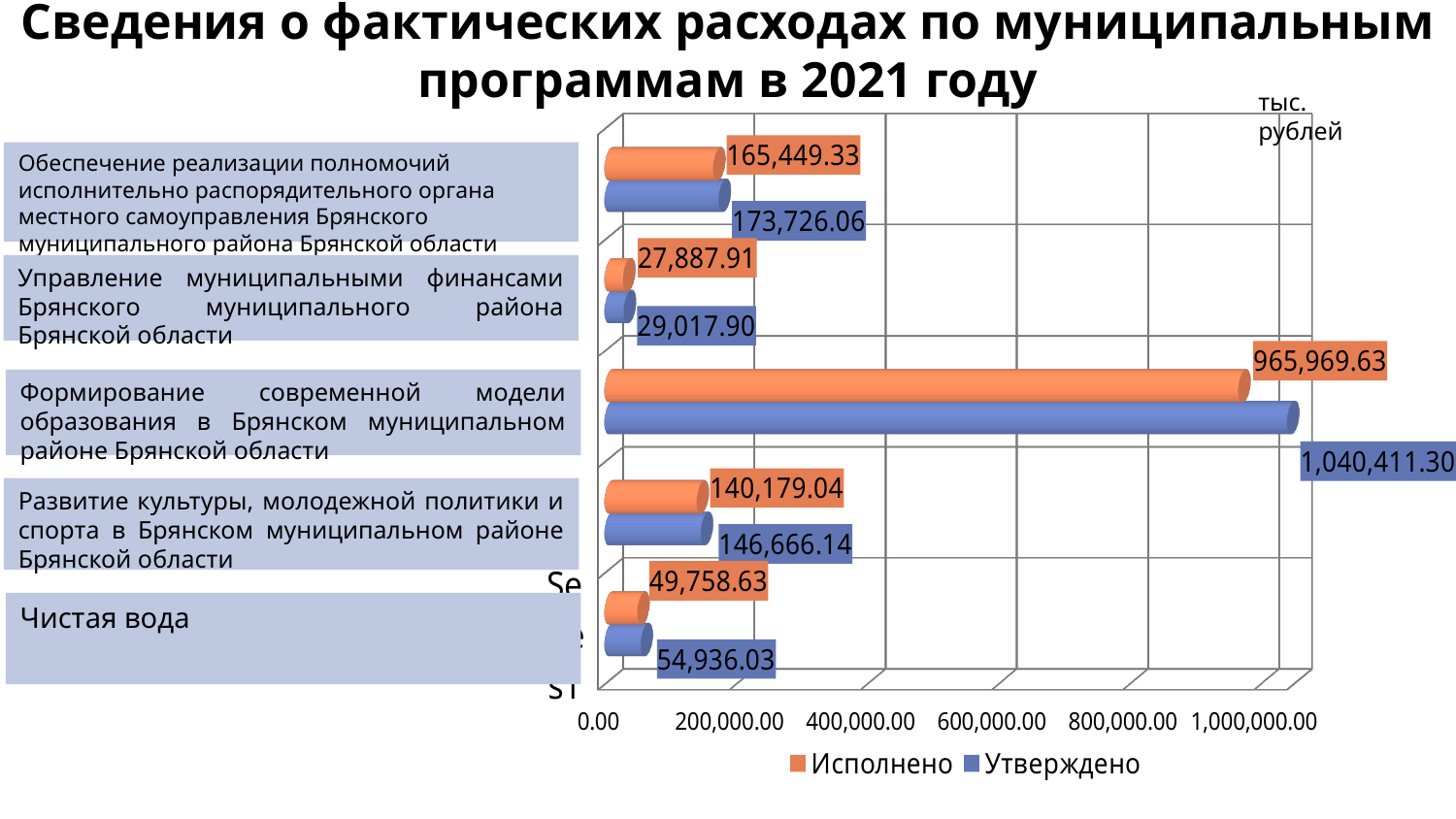
What is the Утверждено value for Формирование современной модели образования в Брянском муниципальном районе Брянской области? 1,040,411.30 What is the difference between the Утверждено and Исполнено values for Чистая вода? 5,177.40 What is the difference between the Утверждено and Исполнено values for Формирование современной модели образования в Брянском муниципальном районе Брянской области? 74,441.67 Which program has the highest Исполнено value? Формирование современной модели образования в Брянском муниципальном районе Брянской области What is the Утверждено value for Развитие культуры, молодежной политики и спорта в Брянском муниципальном районе Брянской области? 146,666.14 How many programs (categories) are shown in the chart? 5 What is the Исполнено value for Чистая вода? 49,758.63 How many series does the legend list? 2 For Обеспечение реализации полномочий исполнительно распорядительного органа местного самоуправления, which is larger: Исполнено or Утверждено? Утверждено What is the Исполнено value for Управление муниципальными финансами Брянского муниципального района Брянской области? 27,887.91 What type of chart is shown on the slide? Bar chart Which program has the lowest Утверждено value? Управление муниципальными финансами Брянского муниципального района Брянской области